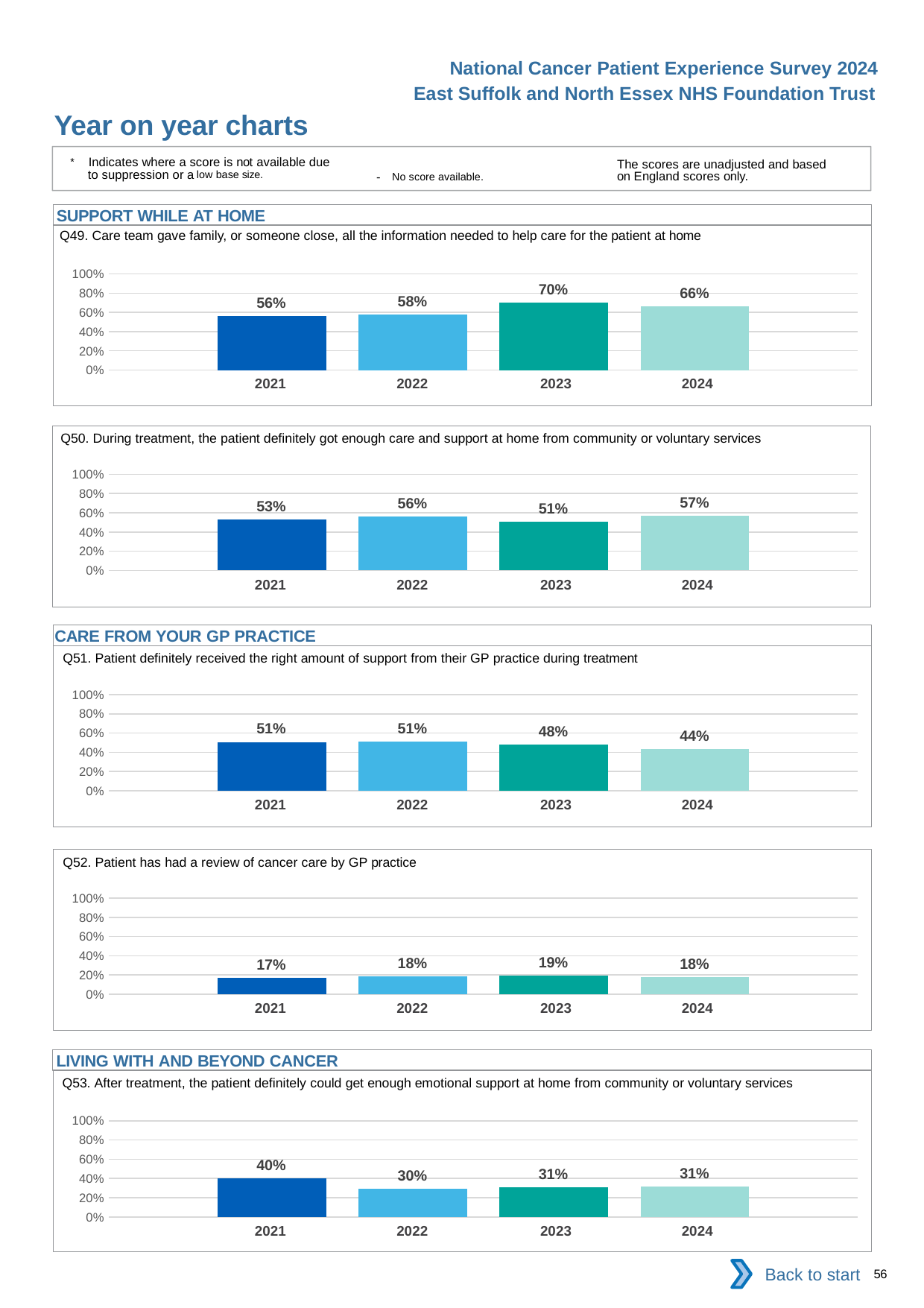
In the Q51 chart, do the values rise or fall from 2022 to 2024? fall In the Q50 chart, what is the value for 2024? 57% How many years are shown in the Q53 chart? 4 In the Q50 chart, which year has the lowest value? 2023 In the Q49 chart, which year has the lowest value? 2021 What kind of chart is the Q49 chart? bar chart In the Q52 chart, is the value for 2021 greater or less than 20%? less In the Q51 chart, what is the difference between the 2021 and 2024 values? 7% In the Q53 chart, which is larger, the value for 2021 or the value for 2022? 2021 In the Q49 chart, what is the value for 2023? 70% In the Q52 chart, which year has the highest value? 2023 In the Q53 chart, what is the value for 2021? 40%